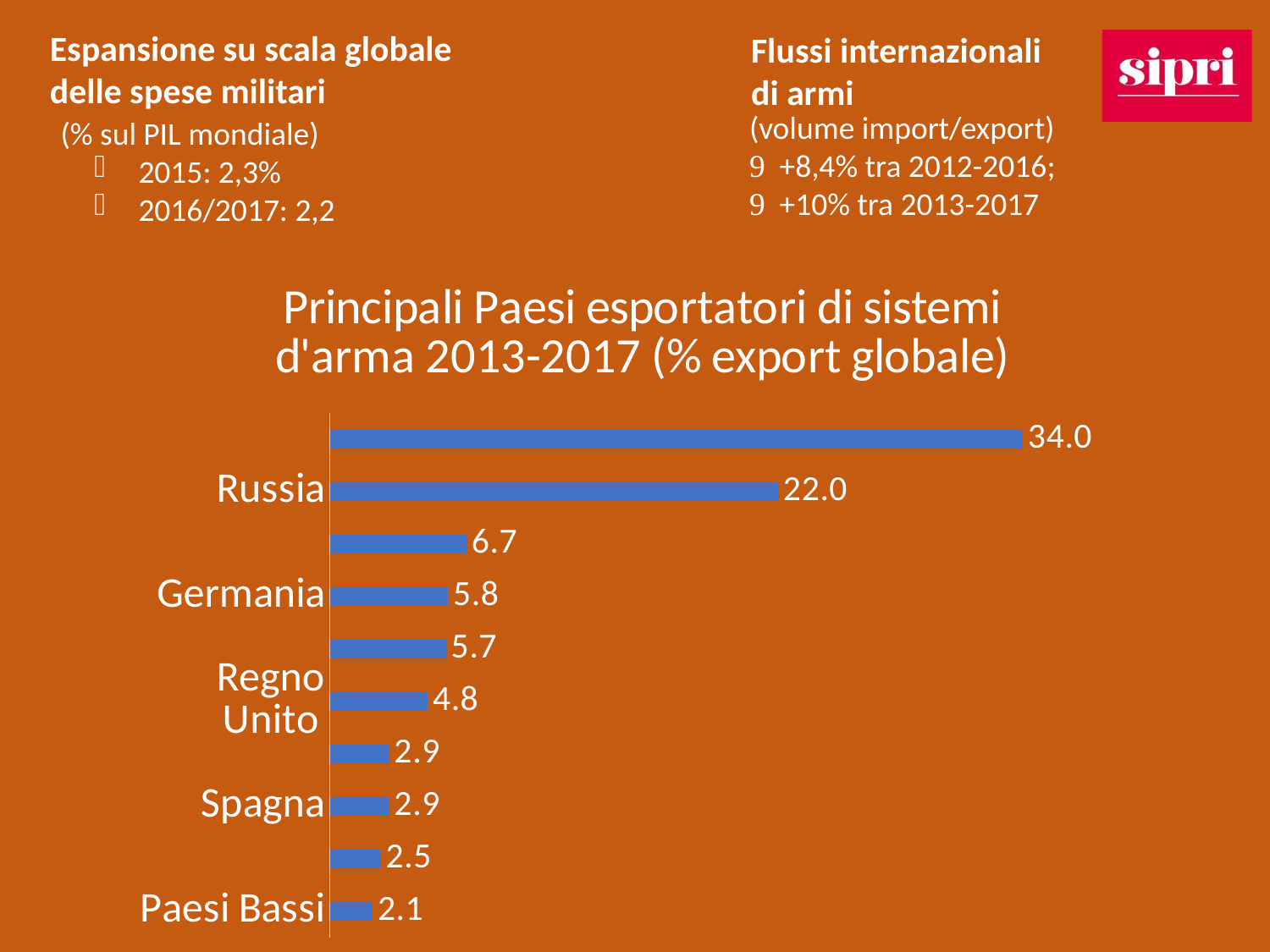
Which of the labelled countries has the lowest value? Paesi Bassi What type of chart is shown on the slide? bar chart Which is larger, the value for Regno Unito or the value for Spagna? Regno Unito What is the value for Regno Unito? 4.8 What is the largest value shown on the chart? 34.0 What is the title of the chart? Principali Paesi esportatori di sistemi d'arma 2013-2017 (% export globale) What is the value for Russia? 22.0 What is the value for Spagna? 2.9 What is the value for Paesi Bassi? 2.1 What is the difference between the values for Russia and Germania? 16.2 What is the value for Germania? 5.8 How many bars are plotted on the chart? 10